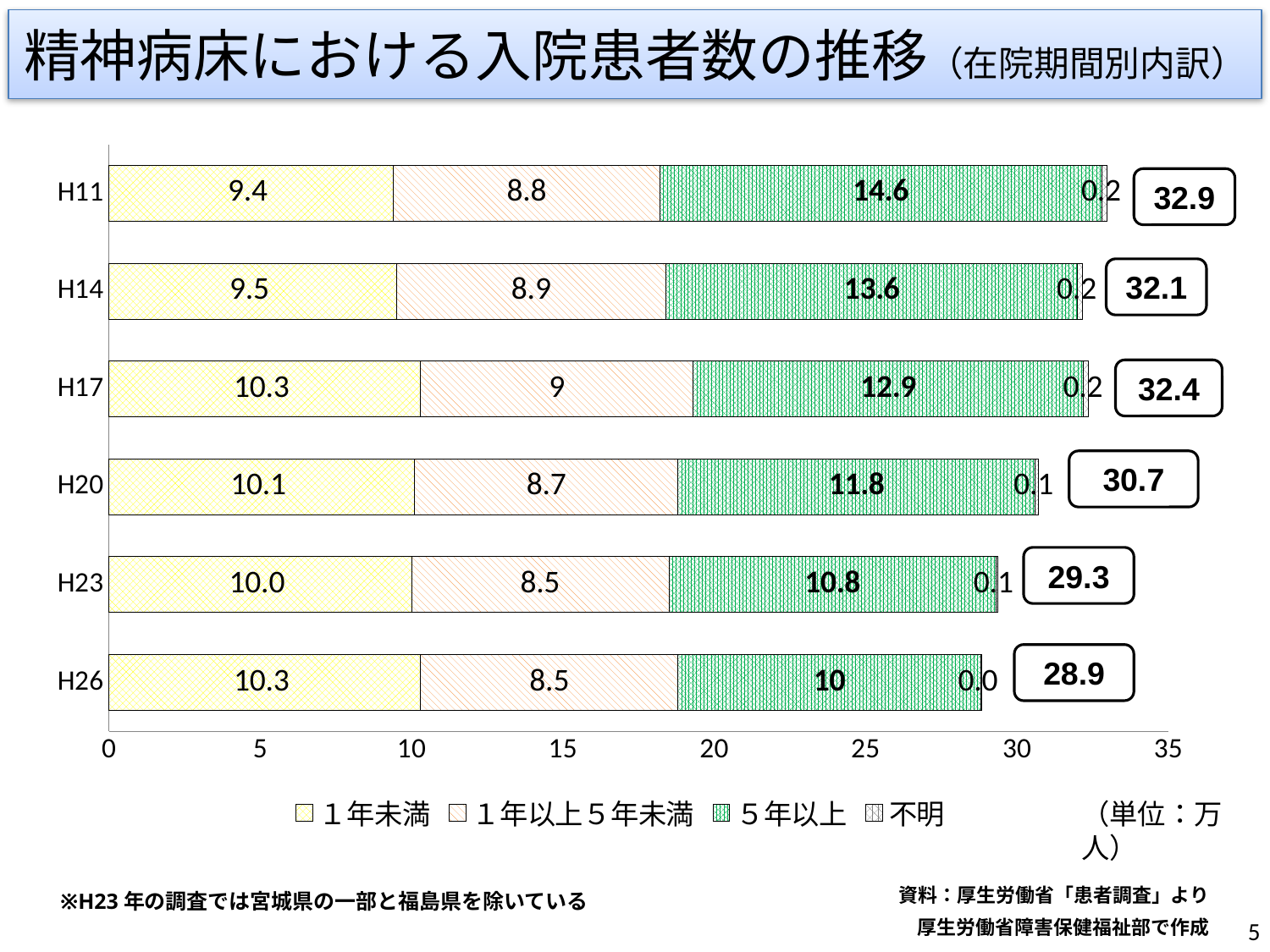
Do the total values rise or fall from H17 to H26? fall Which is larger, the 1年未満 value for H14 or the 1年以上5年未満 value for H14? 1年未満 (9.5) What kind of chart is shown on the slide? stacked bar chart What is the difference between the 5年以上 values for H11 and H26? 4.6 What is the value of the 1年未満 segment for H17? 10.3 How many series does the legend list? 4 What is the total shown for H20? 30.7 Which year has the lowest value for the 5年以上 segment? H26 What is the value of the 1年以上5年未満 segment for H26? 8.5 How many categories (years) are plotted on the chart? 6 Which year has the highest total number of inpatients? H11 What is the value of the 5年以上 segment for H11? 14.6